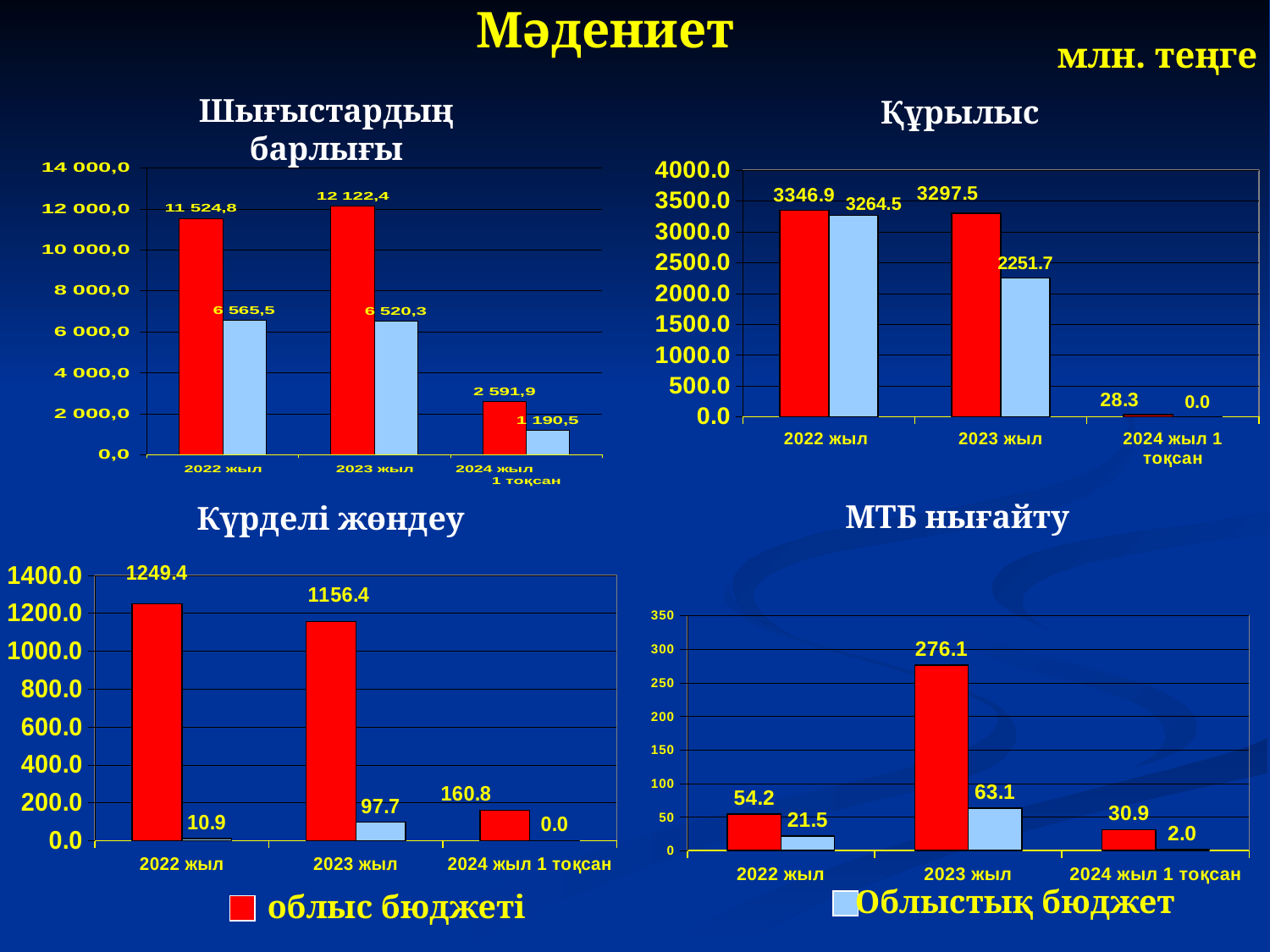
In the 'МТБ нығайту' chart, what is the value of the red bar for 2023 жыл? 276.1 How many categories are shown on the x axis of the 'Күрделі жөндеу' chart? 3 What type of chart is the 'Құрылыс' chart? bar chart In the 'Құрылыс' chart, which year has the highest red bar? 2022 жыл In the 'Құрылыс' chart, what is the value of the light blue bar for 2023 жыл? 2251.7 In the 'МТБ нығайту' chart, is the red bar for 2022 жыл larger or smaller than the light blue bar for 2023 жыл? smaller In the 'Құрылыс' chart, what is the difference between the red and light blue bars for 2023 жыл? 1045.8 In the 'Шығыстардың барлығы' chart, what is the value of the red bar for 2023 жыл? 12 122,4 In the 'Шығыстардың барлығы' chart, what is the value of the light blue bar for 2024 жыл 1 тоқсан? 1 190,5 In the 'Күрделі жөндеу' chart, what is the value of the red bar for 2022 жыл? 1249.4 In the 'Күрделі жөндеу' chart, which year has the lowest light blue bar? 2024 жыл 1 тоқсан In the 'МТБ нығайту' chart, what is the difference between the red and light blue bars for 2024 жыл 1 тоқсан? 28.9